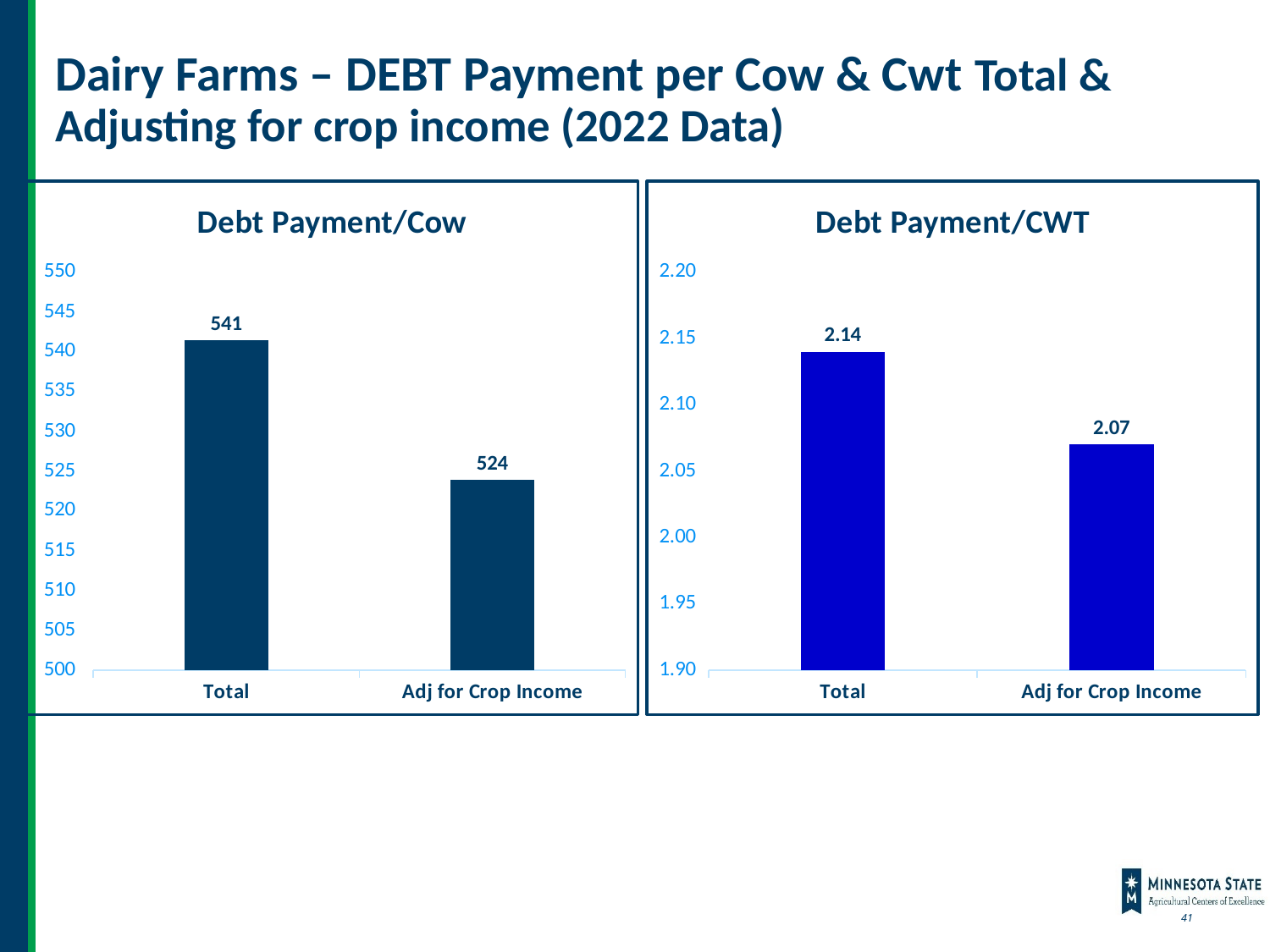
In the Debt Payment/CWT chart, is the value for Total greater or less than 2.10? greater In the Debt Payment/CWT chart, what is the value for Adj for Crop Income? 2.07 In the Debt Payment/CWT chart, which category has the lowest value? Adj for Crop Income In the Debt Payment/CWT chart, what is the value for Total? 2.14 In the Debt Payment/Cow chart, which category has the highest value? Total In the Debt Payment/Cow chart, what is the difference between the Total and Adj for Crop Income values? 17 In the Debt Payment/Cow chart, what is the value for Total? 541 In the Debt Payment/CWT chart, what is the difference between the Total and Adj for Crop Income values? 0.07 What type of chart is the Debt Payment/CWT chart? Bar chart How many categories are shown in the Debt Payment/Cow chart? 2 In the Debt Payment/Cow chart, what is the value for Adj for Crop Income? 524 What is the title of the chart on the left side of the slide? Debt Payment/Cow